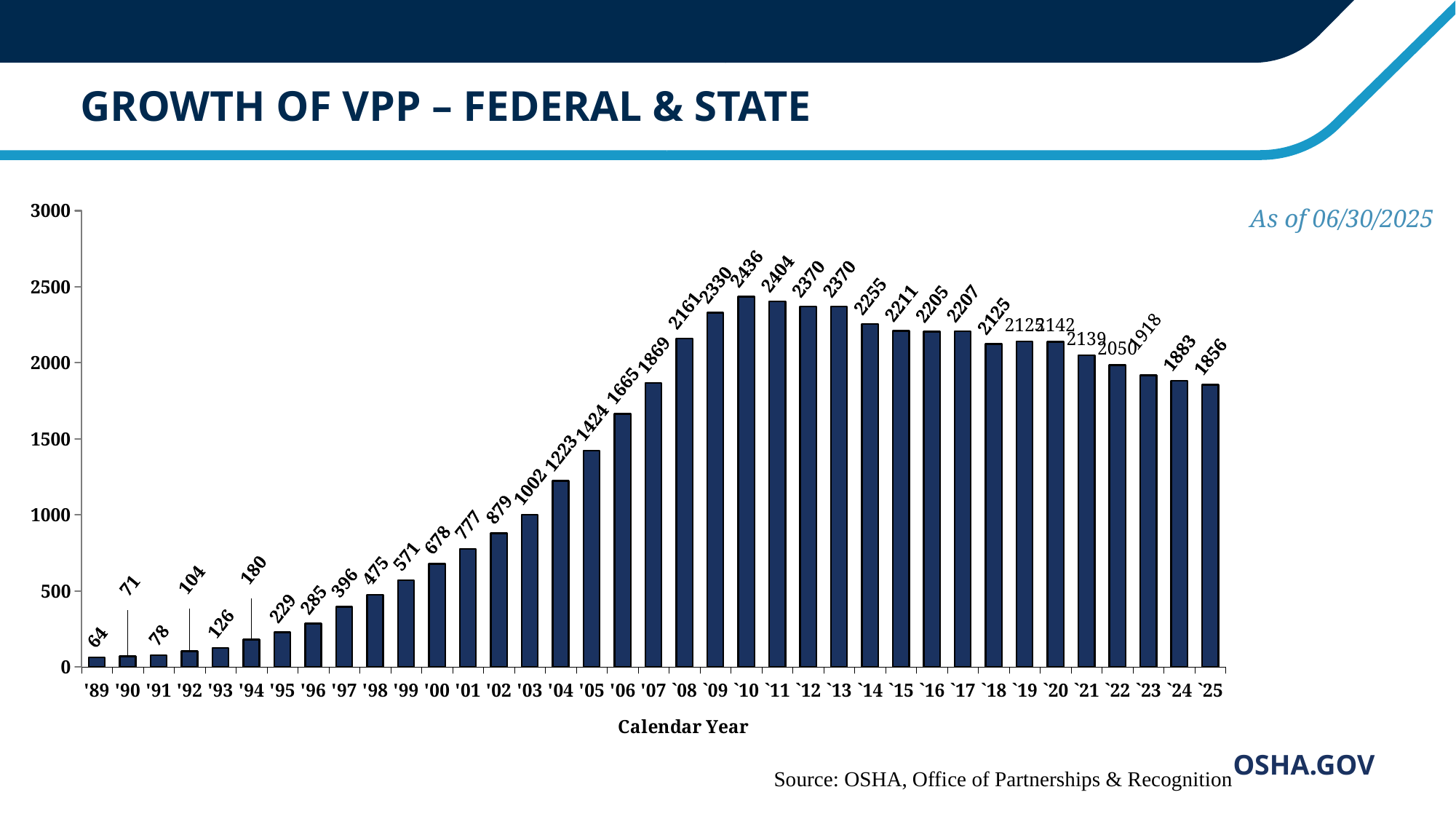
What is the label of the x axis? Calendar Year Which is larger, the value for '08 or the value for '09? '09 What is the value for '10? 2436 What is the value for '25? 1856 What type of chart is shown on the slide? bar chart What is the value for '89? 64 Is the value for '21 greater or less than 2000? greater Which year has the lowest value? '89 What is the value for '04? 1223 Which year has the highest value? '10 What is the difference between the values for '10 and '25? 580 How many years are plotted on the x axis? 37